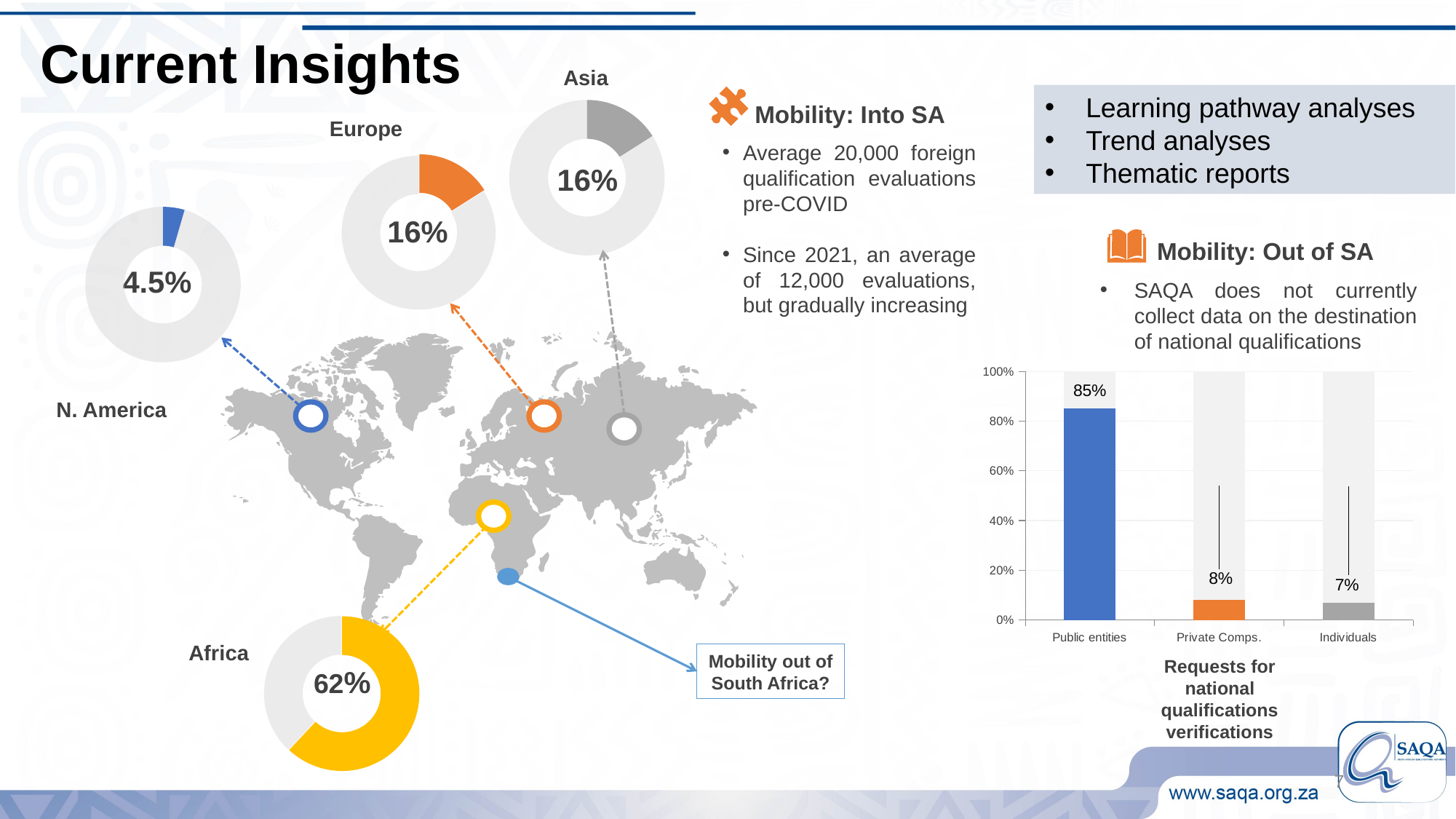
In the bar chart titled 'Requests for national qualifications verifications', what is the value for Public entities? 85% In the bar chart titled 'Requests for national qualifications verifications', what is the difference between Public entities and Private Comps.? 77% In the bar chart titled 'Requests for national qualifications verifications', which category has the highest value? Public entities In the donut chart labelled N. America on the left of the slide, what percentage is shown? 4.5% In the donut chart labelled Africa on the left of the slide, what percentage is shown? 62% Among the donut charts for N. America, Europe, Asia and Africa, which region shows the highest percentage? Africa In the bar chart titled 'Requests for national qualifications verifications', how many categories are shown on the x axis? 3 In the bar chart titled 'Requests for national qualifications verifications', what is the value for Private Comps.? 8% In the bar chart titled 'Requests for national qualifications verifications', is the value for Public entities greater or less than 80%? greater Which is larger: the percentage shown in the Europe donut chart or the N. America donut chart? Europe What kind of chart is 'Requests for national qualifications verifications'? Bar chart In the bar chart titled 'Requests for national qualifications verifications', what is the value for Individuals? 7%